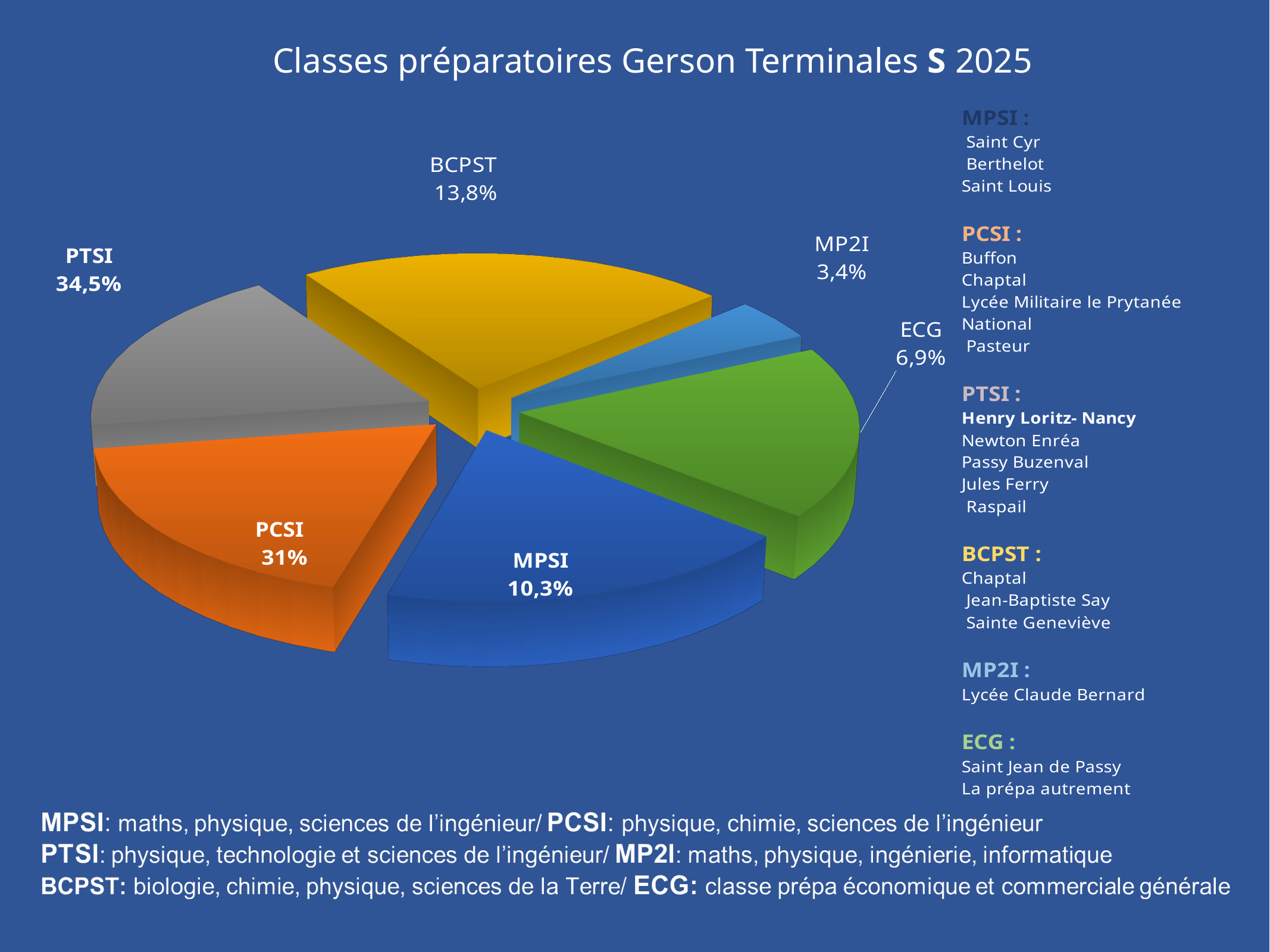
What is the value shown for ECG? 6,9% What percentage is labelled for BCPST? 13,8% What type of chart is shown on the slide? Pie chart What percentage of the pie chart is PTSI? 34,5% Which is larger, the BCPST share or the MPSI share? BCPST What is the title of the chart? Classes préparatoires Gerson Terminales S 2025 What is the value shown for MPSI? 10,3% Which category has the smallest slice of the pie? MP2I What is the difference in percentage points between PTSI and PCSI? 3,5 What share does PCSI have in the pie chart? 31% How many slices does the pie chart have? 6